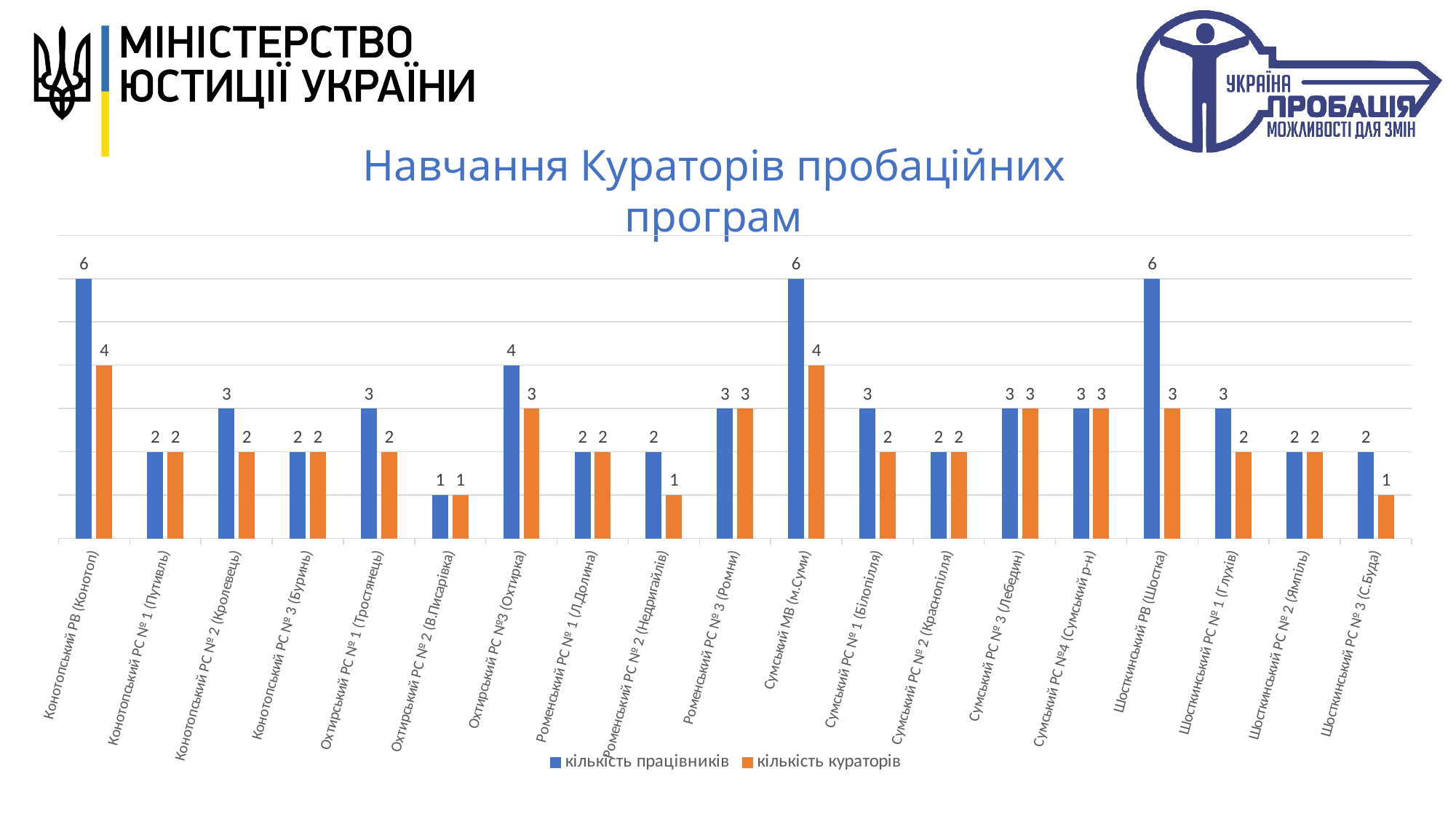
How many series does the legend list? 2 What is the difference between кількість працівників and кількість кураторів for Шосткинський РВ (Шостка)? 3 Which is larger: кількість працівників for Роменський РС № 2 (Недригайлів) or кількість кураторів for the same category? кількість працівників Which category has the lowest value of кількість працівників? Охтирський РС № 2 (В.Писарівка) What is the value of кількість працівників for Конотопський РВ (Конотоп)? 6 What type of chart is shown on the slide? bar chart What is the value of кількість кураторів for Охтирський РС №3 (Охтирка)? 3 Which is larger: кількість кураторів for Конотопський РВ (Конотоп) or кількість кураторів for Шосткинський РВ (Шостка)? Конотопський РВ (Конотоп) What is the difference between кількість працівників and кількість кураторів for Сумський МВ (м.Суми)? 2 What is the title of the chart? Навчання Кураторів пробаційних програм How many categories are shown on the x axis? 19 What is the value of кількість кураторів for Шосткинський РВ (Шостка)? 3